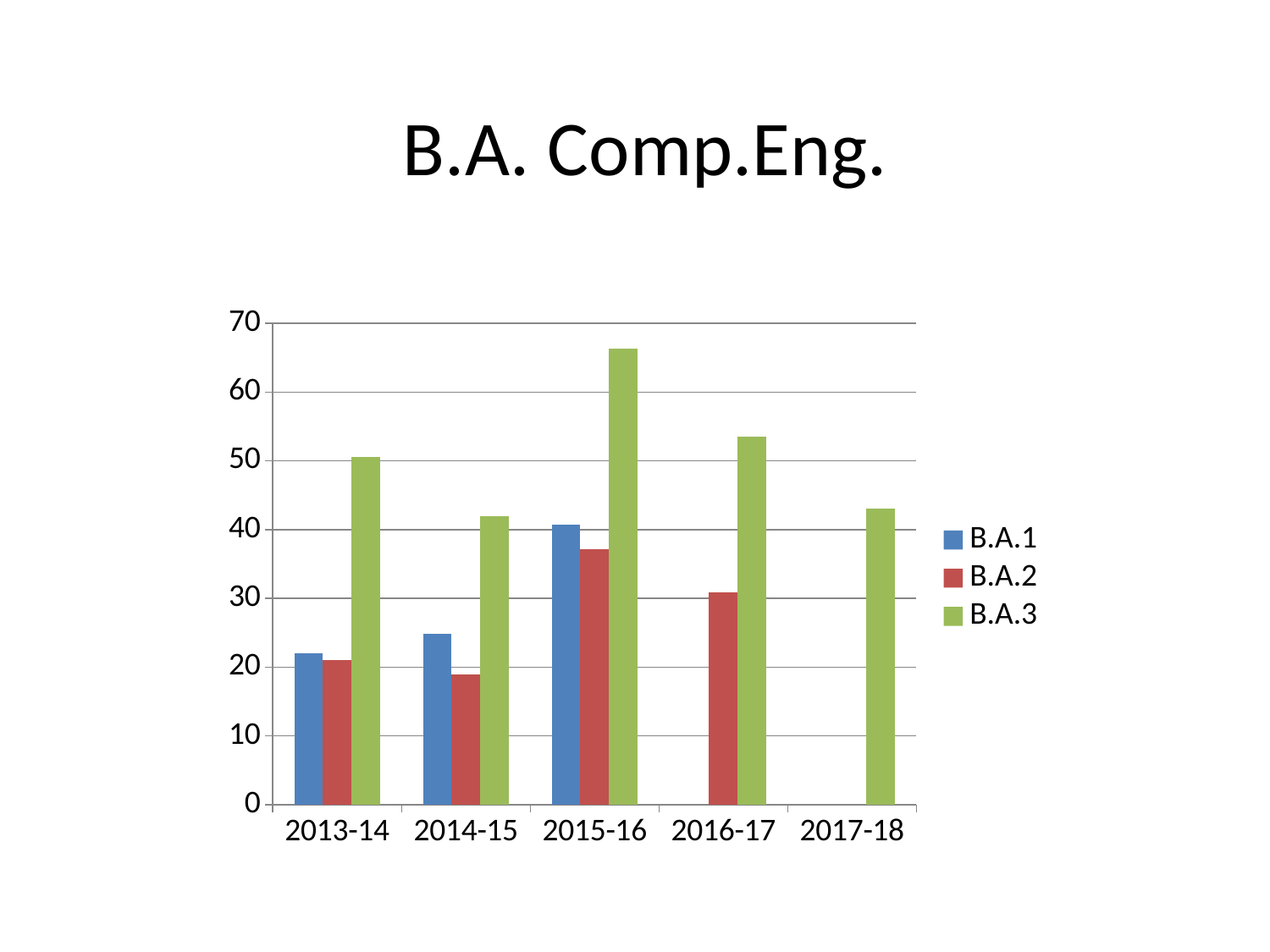
Is the B.A.1 value for 2014-15 greater or less than 30? less What is the title of the chart? B.A. Comp.Eng. In 2015-16, which is larger, B.A.1 or B.A.2? B.A.1 Is the B.A.3 value for 2017-18 greater or less than 40? greater Which year has the larger B.A.3 value, 2013-14 or 2014-15? 2013-14 How many academic years are shown on the x axis? 5 In which year is the B.A.3 value highest? 2015-16 In which year is the B.A.2 value lowest? 2014-15 In which year is the B.A.1 value highest? 2015-16 How many series does the legend list? 3 Is the B.A.3 value for 2015-16 greater or less than 60? greater What kind of chart is shown on the slide? bar chart